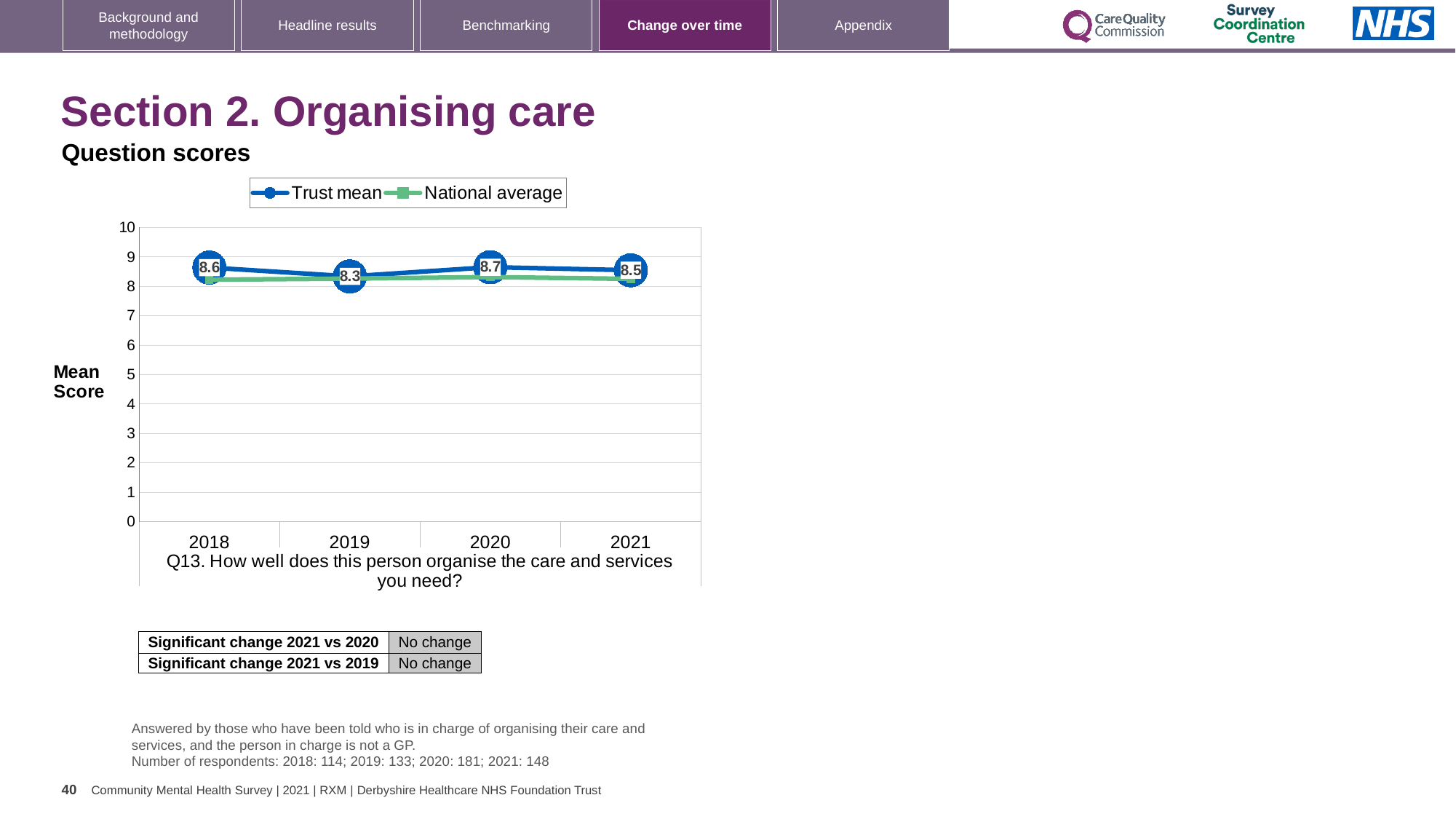
In which year is the Trust mean score highest? 2020 In which year is the Trust mean score lowest? 2019 Between 2019 and 2020, does the Trust mean score rise or fall? rise Which year has the larger Trust mean score, 2018 or 2021? 2018 What is the difference between the Trust mean scores for 2020 and 2019? 0.4 What kind of chart is shown on the slide? line chart What is the Trust mean score for 2020? 8.7 What is the Trust mean score for 2021? 8.5 What is the Trust mean score for 2018? 8.6 How many years are plotted on the x axis? 4 How many series does the legend list? 2 Is the National average for 2019 greater or less than 9? less